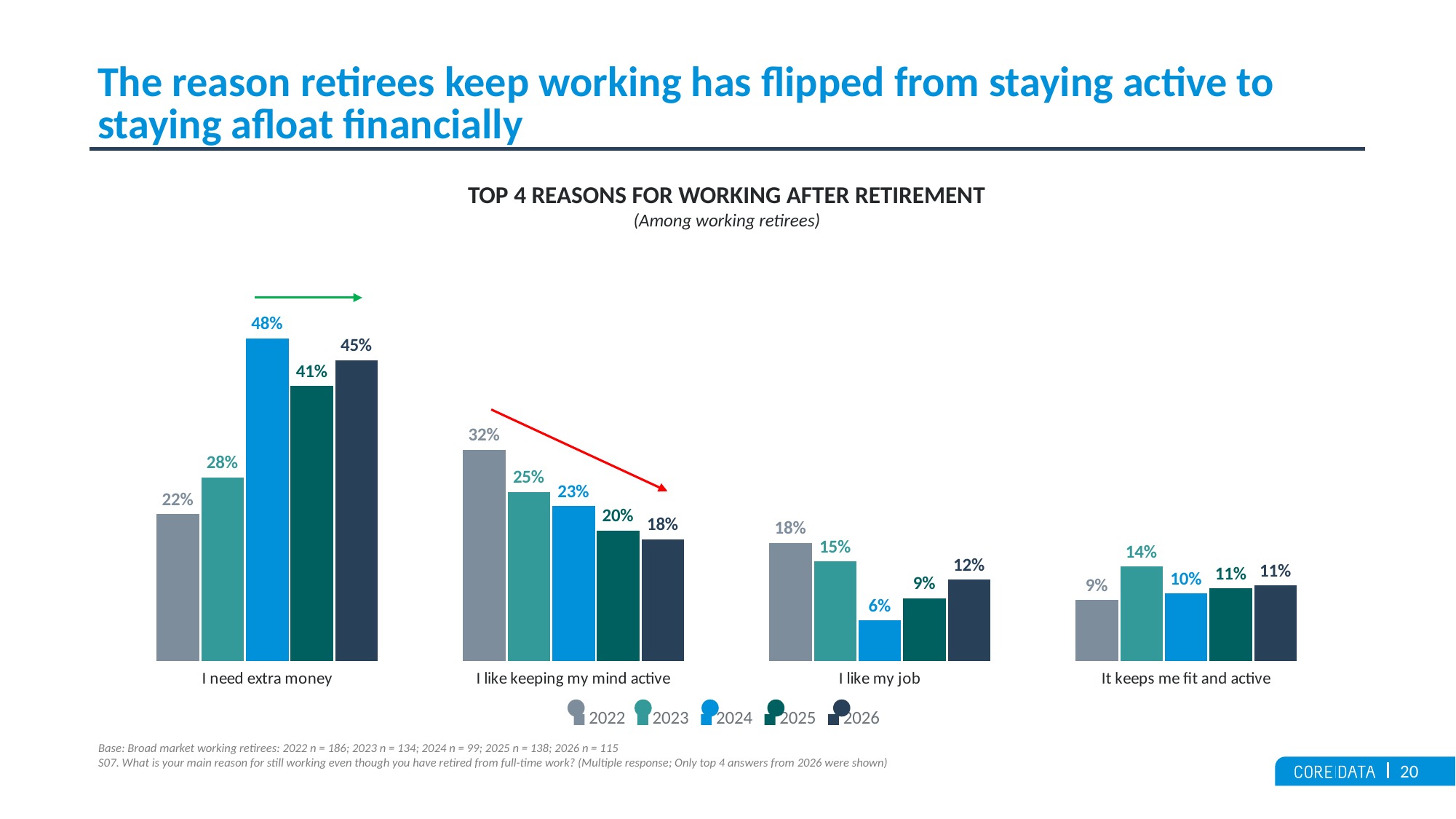
What percentage of working retirees said "I need extra money" in 2024? 48% Do the values for "I like keeping my mind active" rise or fall from 2022 to 2026? Fall What is the 2026 value for "I like keeping my mind active"? 18% What percentage chose "I like my job" in 2024? 6% How many years does the legend list? 5 What is the difference between the 2022 and 2026 values for "I like keeping my mind active"? 14% Which year has the lowest value for "I like my job"? 2024 What kind of chart is shown on the slide? Bar chart How many reasons (categories) are shown on the x axis? 4 Which year has the highest value for "I need extra money"? 2024 What is the 2022 value for "It keeps me fit and active"? 9% Which is larger: the 2025 value for "I need extra money" or the 2026 value for "I need extra money"? 2026